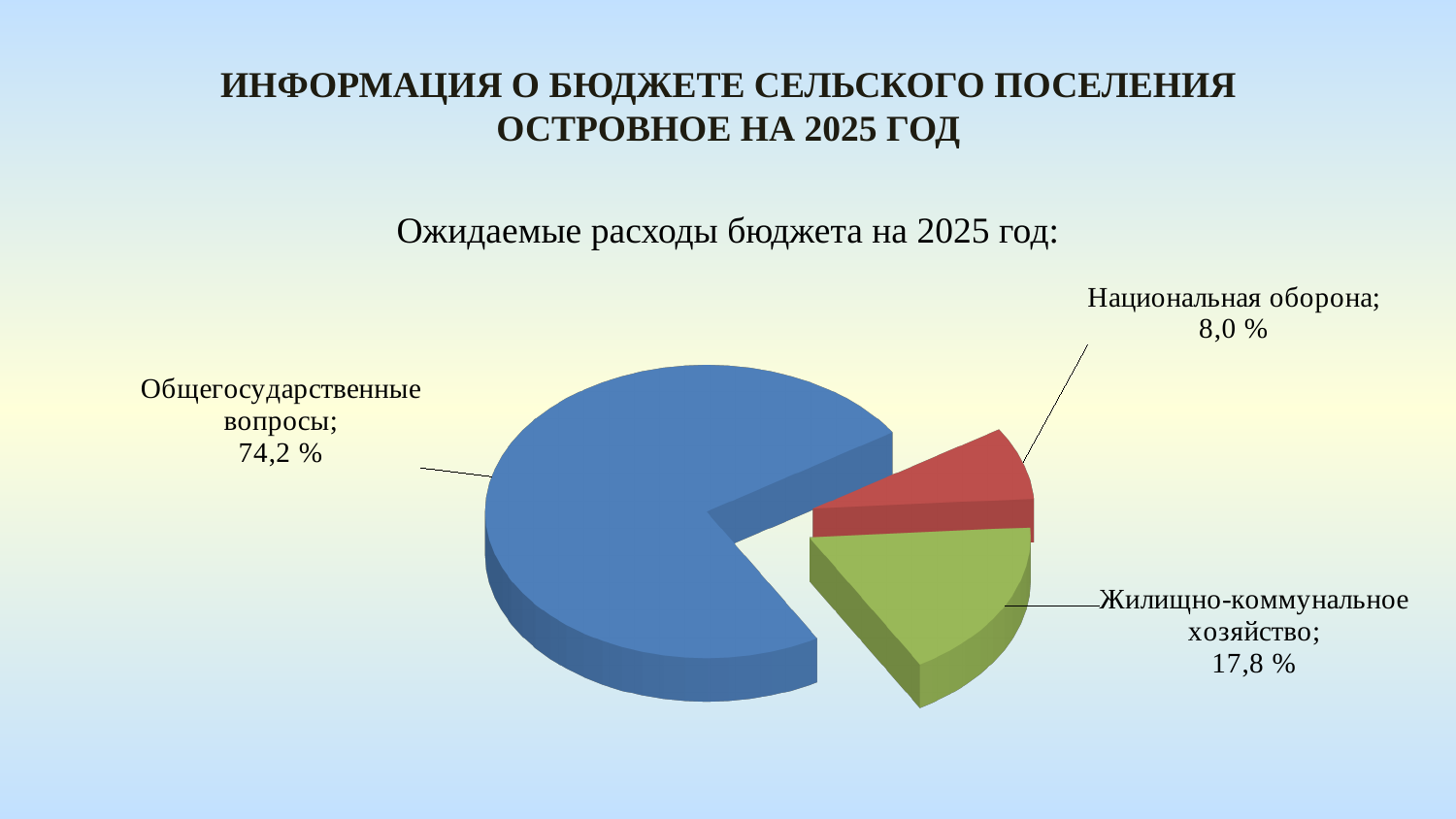
Which category has the largest share of the expected 2025 budget expenditures? Общегосударственные вопросы How many percentage points larger is the share of Общегосударственные вопросы than that of Жилищно-коммунальное хозяйство? 56,4 How many categories are shown in the pie chart? 3 Which has a larger share: Жилищно-коммунальное хозяйство or Национальная оборона? Жилищно-коммунальное хозяйство What share of expected 2025 budget expenditures goes to Национальная оборона? 8,0 % What colour is the slice for Национальная оборона? Red What type of chart is shown on the slide? Pie chart Which category has the smallest share of the expected 2025 budget expenditures? Национальная оборона How many percentage points larger is the share of Жилищно-коммунальное хозяйство than that of Национальная оборона? 9,8 What share of expected 2025 budget expenditures goes to Жилищно-коммунальное хозяйство? 17,8 % What share of expected 2025 budget expenditures goes to Общегосударственные вопросы? 74,2 % What is the subtitle above the chart? Ожидаемые расходы бюджета на 2025 год: